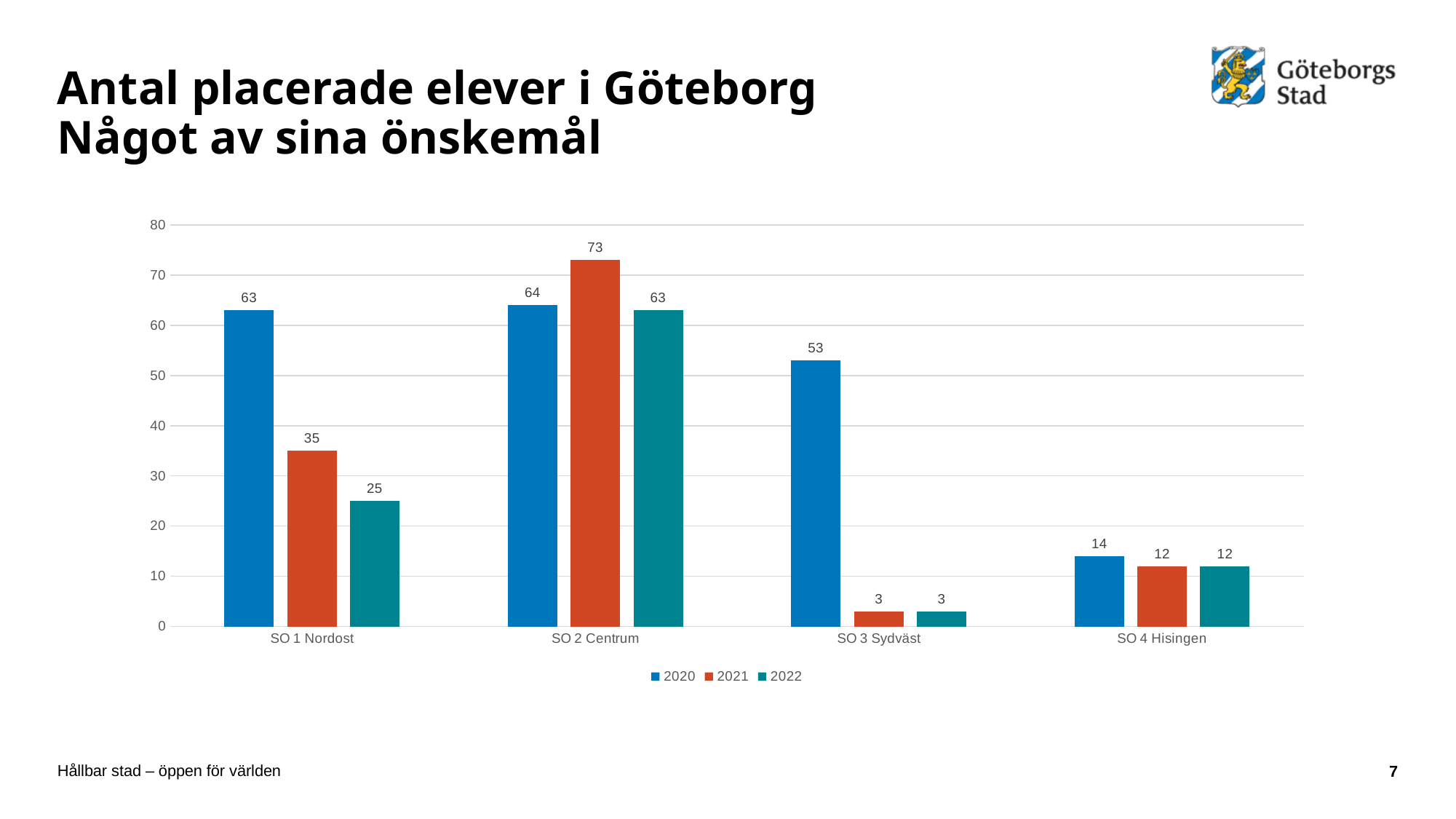
Do the values for SO 1 Nordost rise or fall from 2020 to 2022? Fall What kind of chart is shown on the slide? Bar chart Which category has the highest value in the 2021 series? SO 2 Centrum What is the value for SO 2 Centrum in 2021? 73 What is the value for SO 4 Hisingen in 2020? 14 How many categories are shown on the x axis? 4 What is the value for SO 1 Nordost in 2020? 63 What is the difference between the 2020 and 2022 values for SO 1 Nordost? 38 Which is larger for SO 3 Sydväst: the 2020 value or the 2021 value? 2020 How many series does the legend list? 3 Which category has the lowest value in the 2022 series? SO 3 Sydväst What is the value for SO 3 Sydväst in 2022? 3